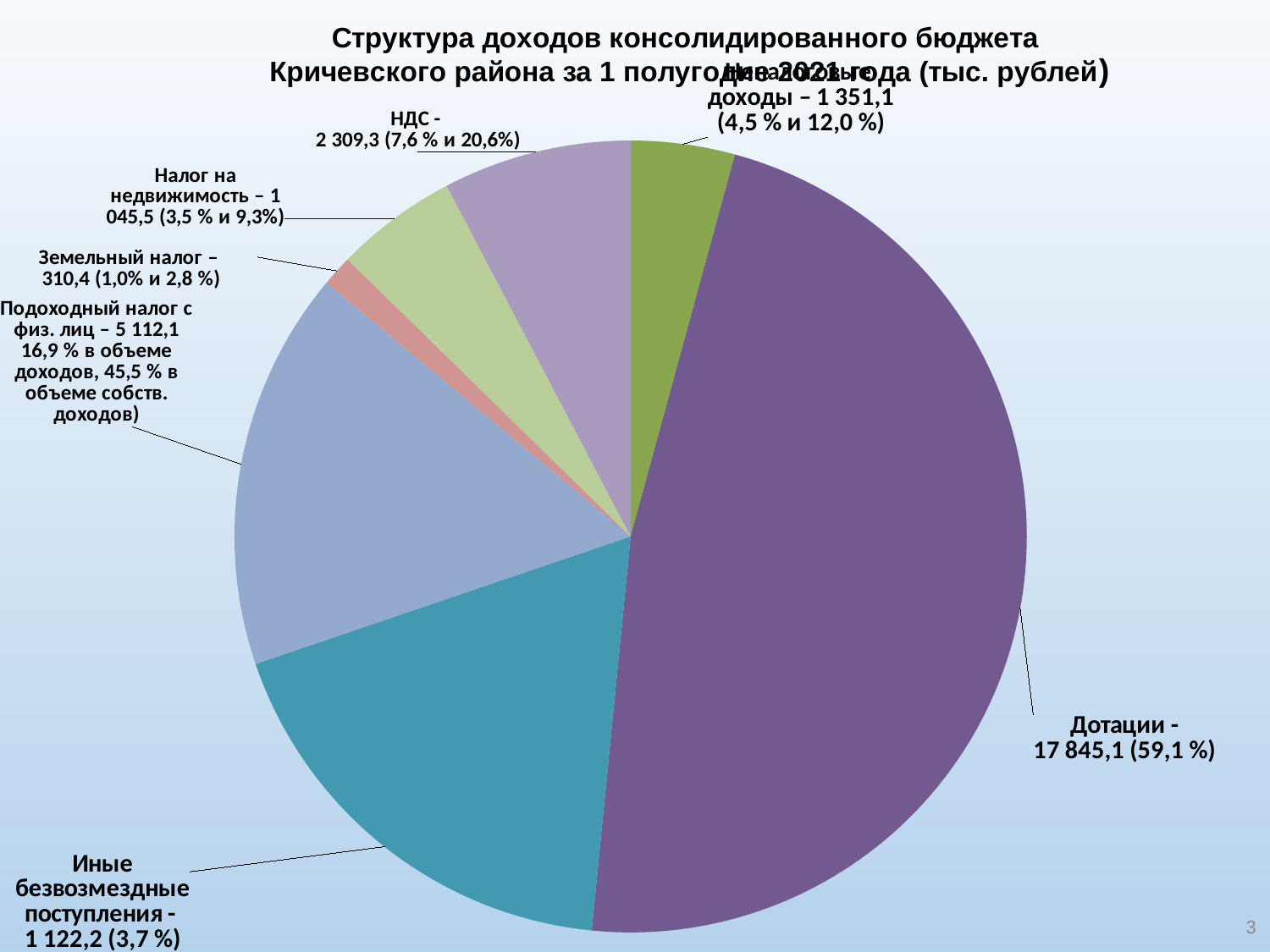
Which category has the largest slice of the pie? Дотации What is the difference between the value for Дотации and the value for Подоходный налог с физ. лиц? 12 733,0 Which is larger, НДС or Налог на недвижимость? НДС What is the value for Земельный налог? 310,4 What share of the pie does Дотации account for? 59,1 % Which category has the smallest value? Земельный налог What is the title of the chart? Структура доходов консолидированного бюджета Кричевского района за 1 полугодие 2021 года (тыс. рублей) What type of chart is shown on the slide? pie chart How many slices does the pie chart have? 7 What is the value for Дотации? 17 845,1 What is the value for Иные безвозмездные поступления? 1 122,2 What is the value for НДС? 2 309,3